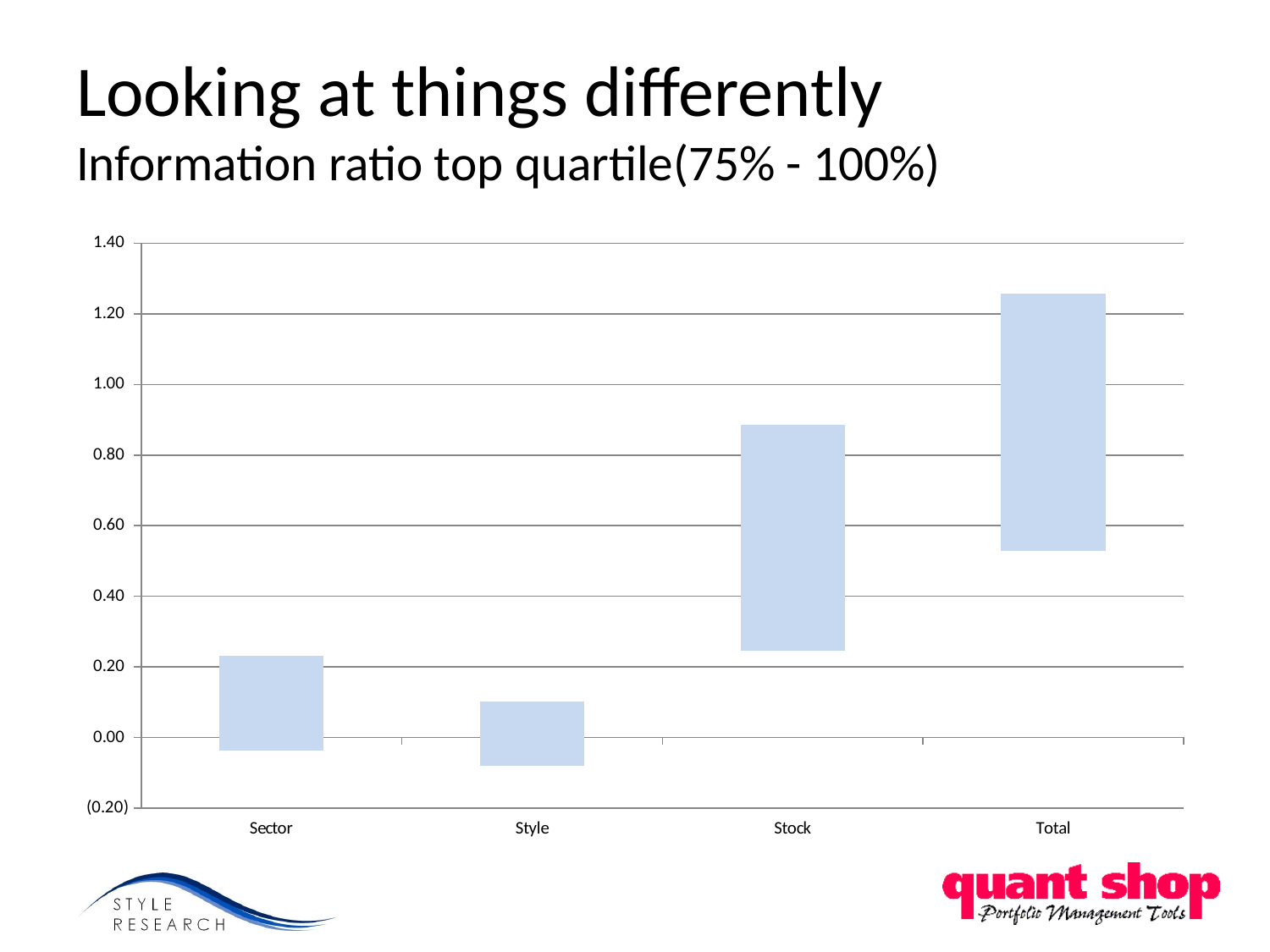
Is the bottom of the Stock bar greater or less than 0.40? less Is the top of the Sector bar greater or less than 0.40? less Is the top of the Stock bar greater or less than 1.00? less What kind of chart is shown on the slide? bar chart Which bar reaches higher, Stock or Style? Stock Which category's bar reaches the highest value on the chart? Total How many categories are shown on the x axis of the chart? 4 What is the subtitle shown above the chart? Information ratio top quartile(75% - 100%) Which bar reaches higher, Sector or Style? Sector Which category's bar has the lowest top on the chart? Style